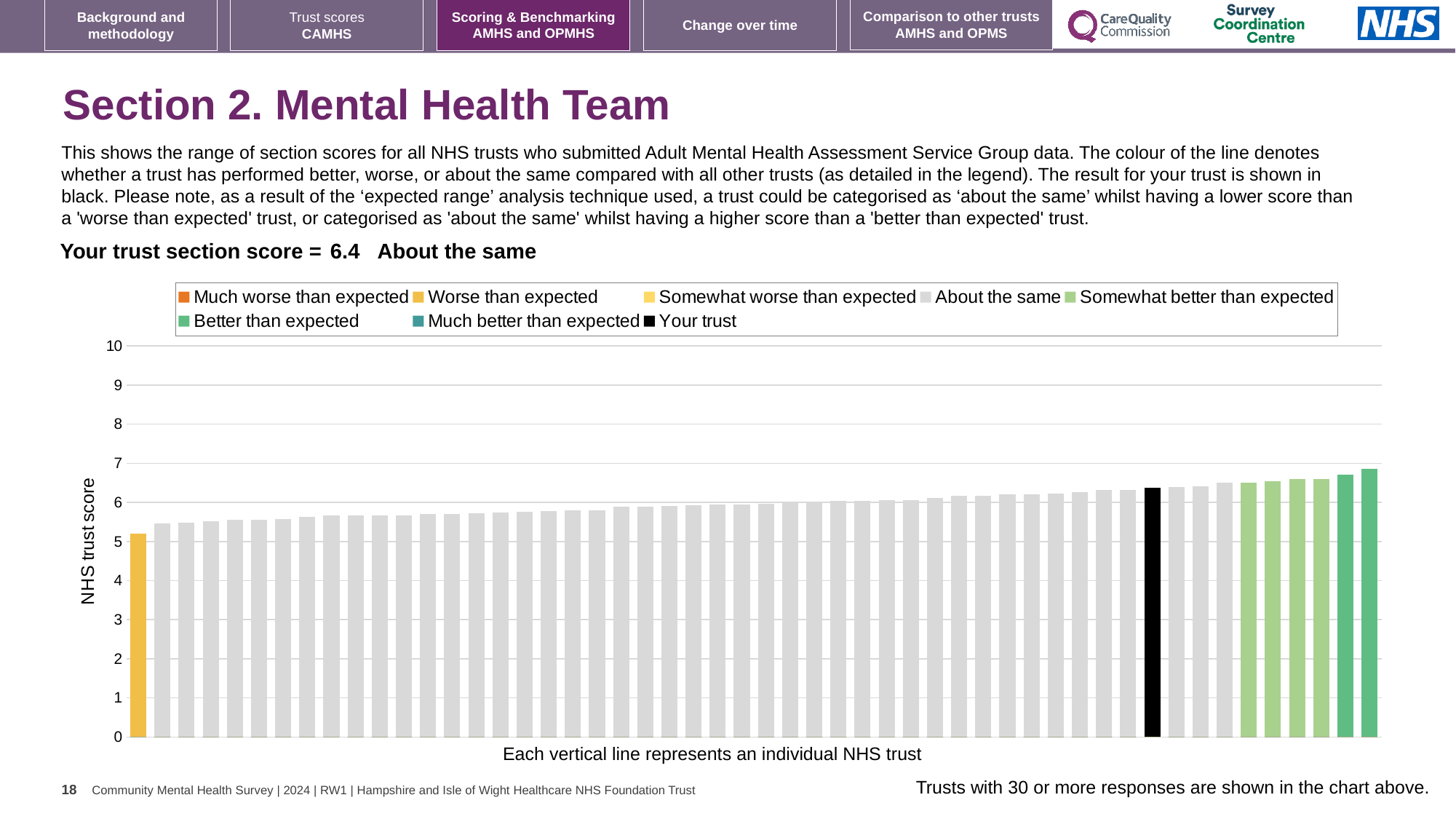
Which legend category does the shortest bar belong to? Worse than expected How many entries does the chart legend list? 8 Is the value of the black 'Your trust' bar greater or less than 6? greater How many bars are coloured as 'Somewhat better than expected'? 4 Is the value of the tallest bar greater or less than 7? less What is the section score for your trust shown on the slide? 6.4 Do the bar values rise or fall from left to right along the x axis? Rise Which legend category does the tallest bar belong to? Better than expected Is the value of the leftmost (yellow) bar greater or less than 6? less Which category is your trust placed in for this section? About the same What is the label on the vertical axis of the chart? NHS trust score What kind of chart is shown on the slide? Bar chart